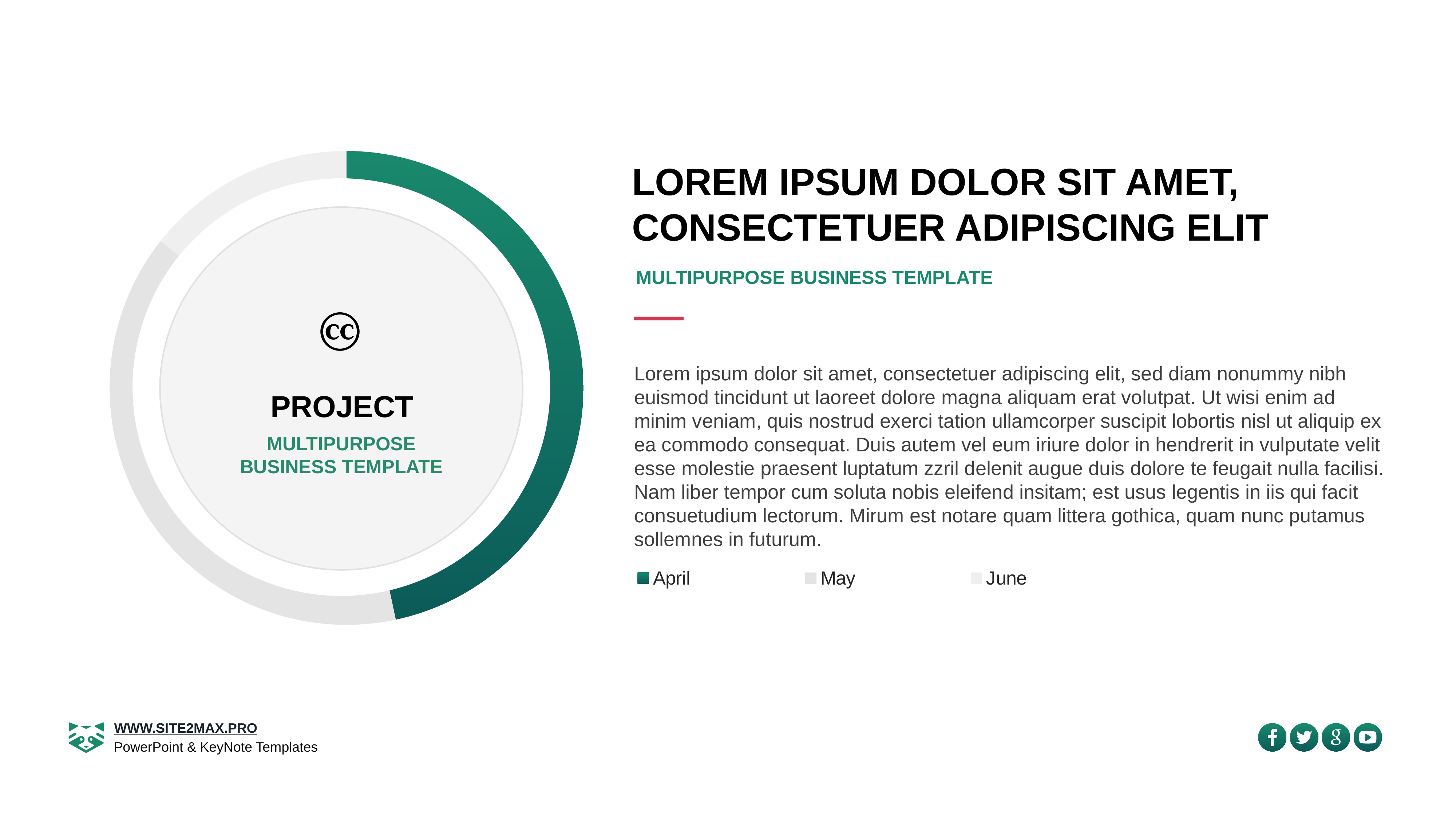
How many series does the chart's legend list? 3 What colour is the April segment of the doughnut chart? Green How many segments does the doughnut chart have? 3 What are the three entries listed in the chart's legend? April, May, June Which is larger in the doughnut chart, the April segment or the June segment? April What kind of chart is shown on the left of the slide? Doughnut chart Which is larger in the doughnut chart, the April segment or the May segment? April Which series has the largest segment in the doughnut chart? April